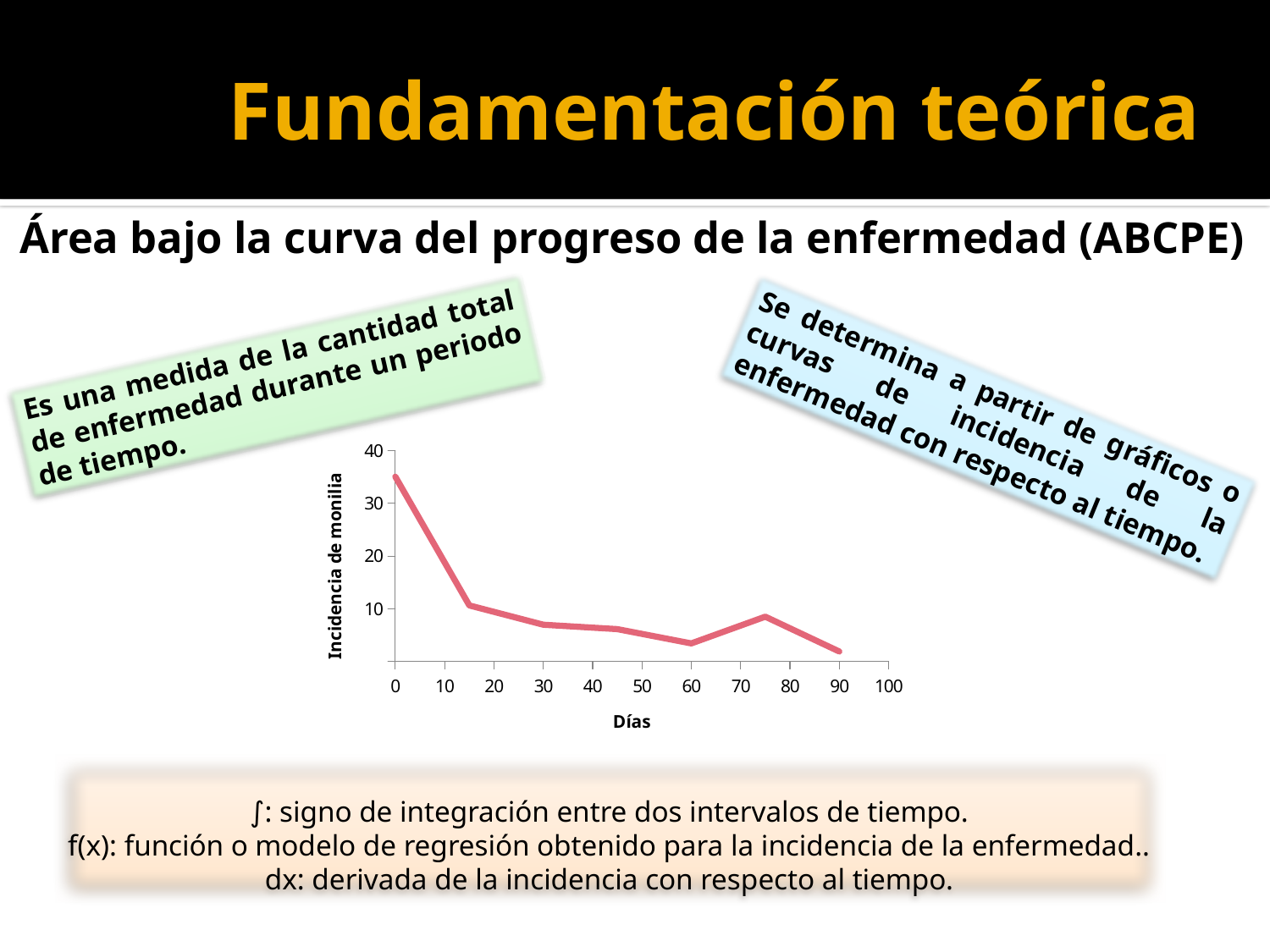
Which has a higher incidence value, day 0 or day 15? day 0 Is the incidence value at day 0 greater or less than 30? greater What is the label of the x axis of the chart? Días Does the incidence of monilia generally rise or fall from day 0 to day 90? fall What is the highest value shown on the y axis of the chart? 40 Is the incidence value at day 15 greater or less than 20? less Which has a higher incidence value, day 60 or day 75? day 75 What kind of chart is shown on the slide? line chart Is the incidence value at day 75 greater or less than 10? less What is the label of the y axis of the chart? Incidencia de monilia At which day is the incidence of monilia highest? 0